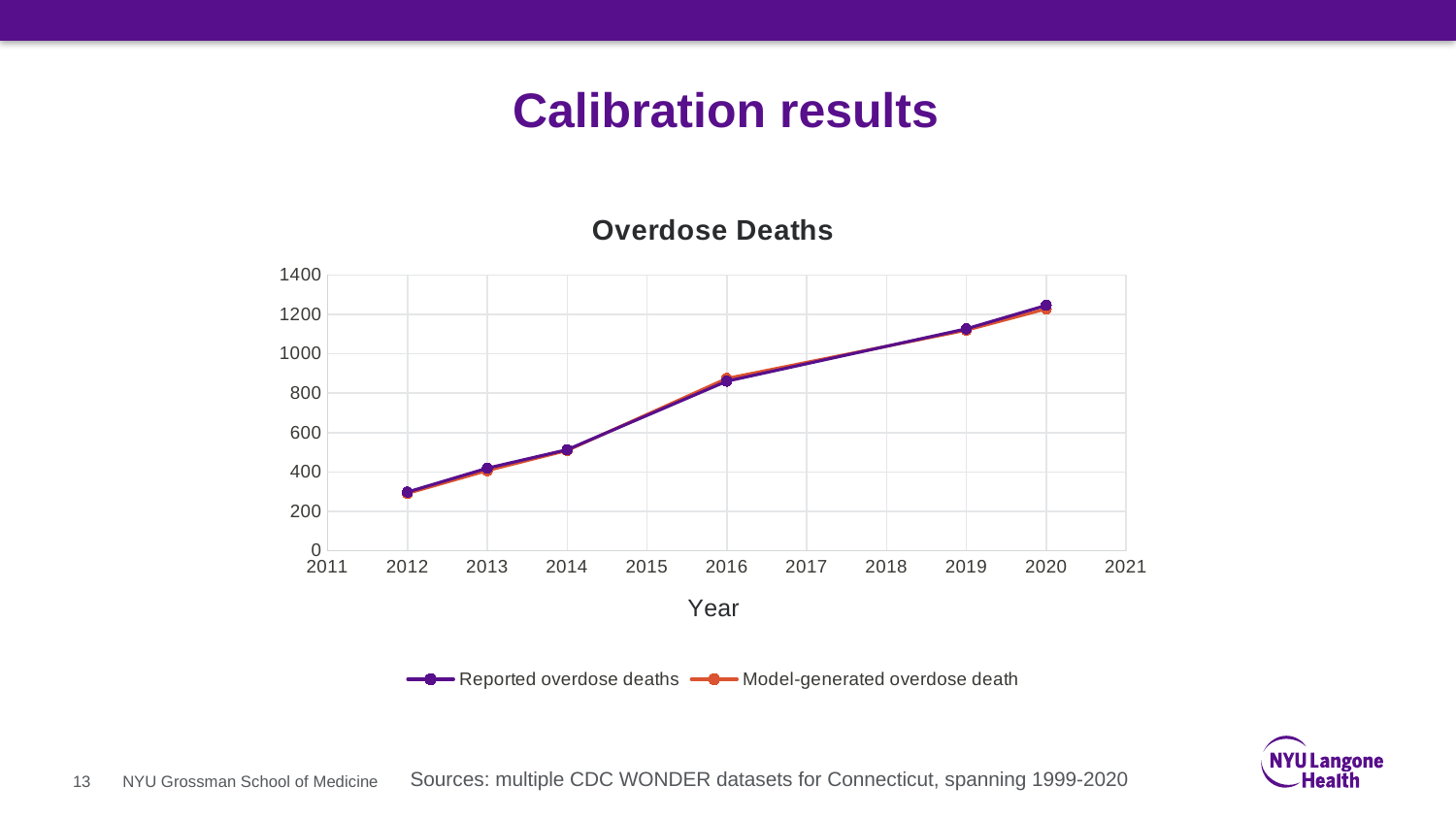
What is the label of the x axis? Year Do the reported overdose deaths rise or fall from 2012 to 2020? Rise Is the value for Reported overdose deaths in 2012 greater or less than 400? less Is the value for Reported overdose deaths in 2014 greater or less than 600? less What kind of chart is shown on the slide? Line chart How many data points are plotted for the Reported overdose deaths series? 6 What is the title of the chart? Overdose Deaths In which year are the reported overdose deaths lowest? 2012 Is the value for Reported overdose deaths in 2019 greater or less than 1000? greater In which year are the reported overdose deaths highest? 2020 How many series does the legend list? 2